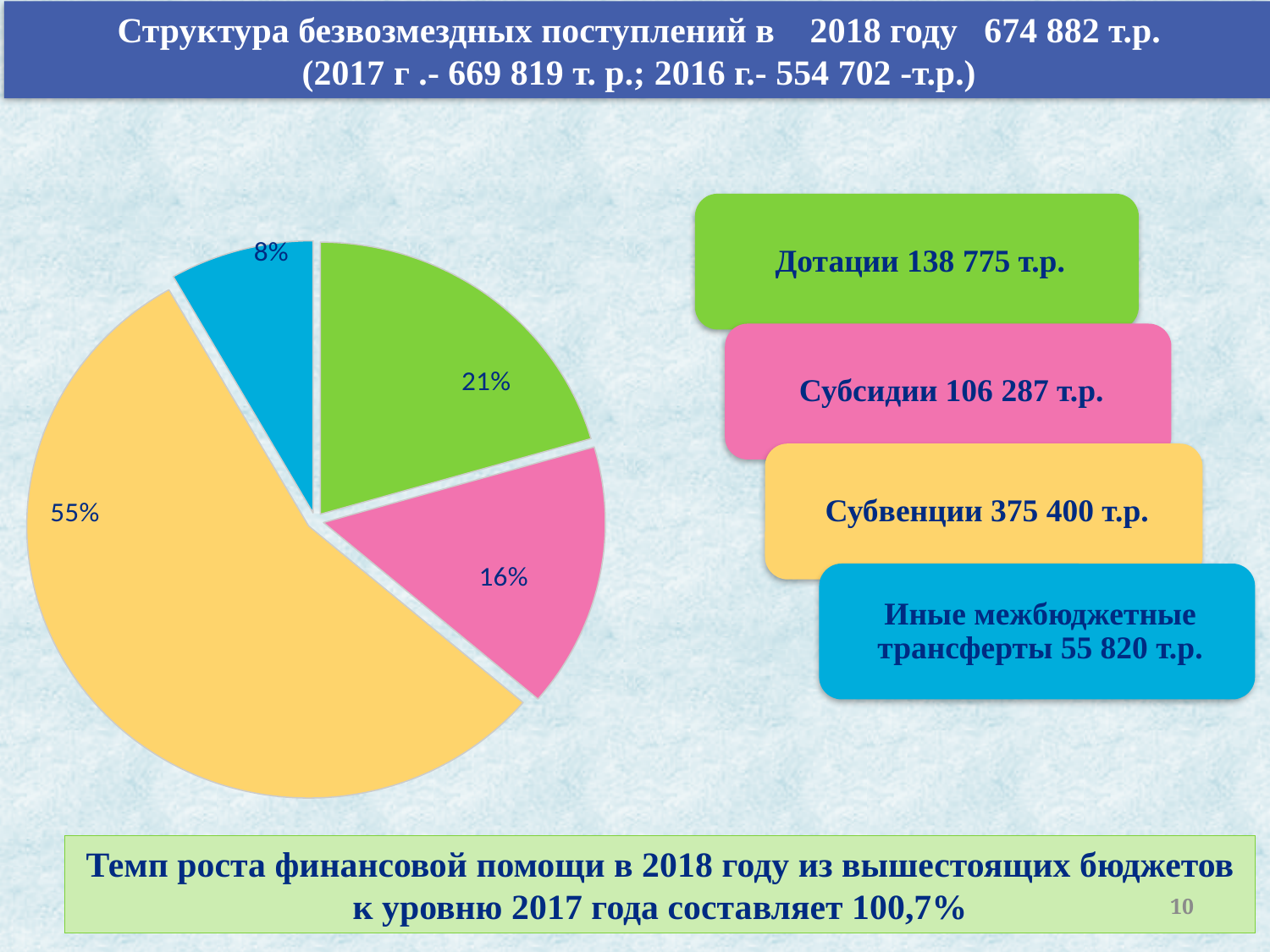
How many slices does the pie chart have? 4 What share of the pie does the Дотации slice represent? 21% What share of the pie does the Иные межбюджетные трансферты slice represent? 8% What type of chart is shown on the slide? pie chart What value in т.р. is given for Субвенции in the legend box? 375 400 т.р. What share of the pie does the Субвенции slice represent? 55% Which category has the largest slice of the pie? Субвенции What colour is the Субсидии slice of the pie? pink What is the difference in percentage points between the Субвенции slice and the Дотации slice? 34 Which is larger, the Дотации slice or the Субсидии slice? Дотации Which category has the smallest slice of the pie? Иные межбюджетные трансферты